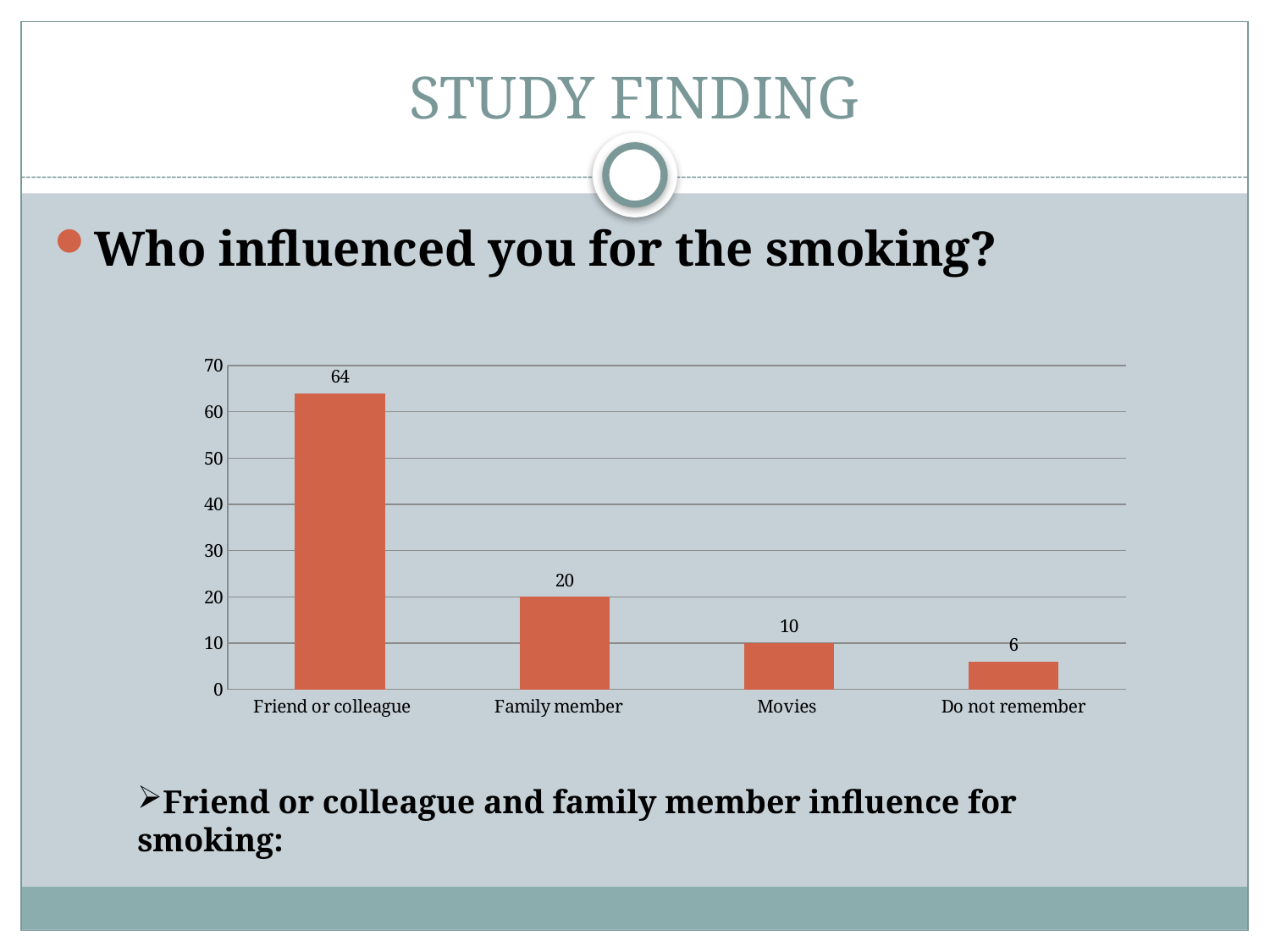
What is the value for Family member? 20 What is the value for Do not remember? 6 Do the values rise or fall from left to right along the x axis? Fall What is the value for Movies? 10 How many categories are shown on the x axis? 4 What kind of chart is shown on the slide? Bar chart What is the difference between the values for Movies and Do not remember? 4 Which category has the highest value? Friend or colleague What is the difference between the values for Friend or colleague and Family member? 44 Which category has the lowest value? Do not remember Which is larger, the value for Family member or the value for Movies? Family member What is the value for Friend or colleague? 64